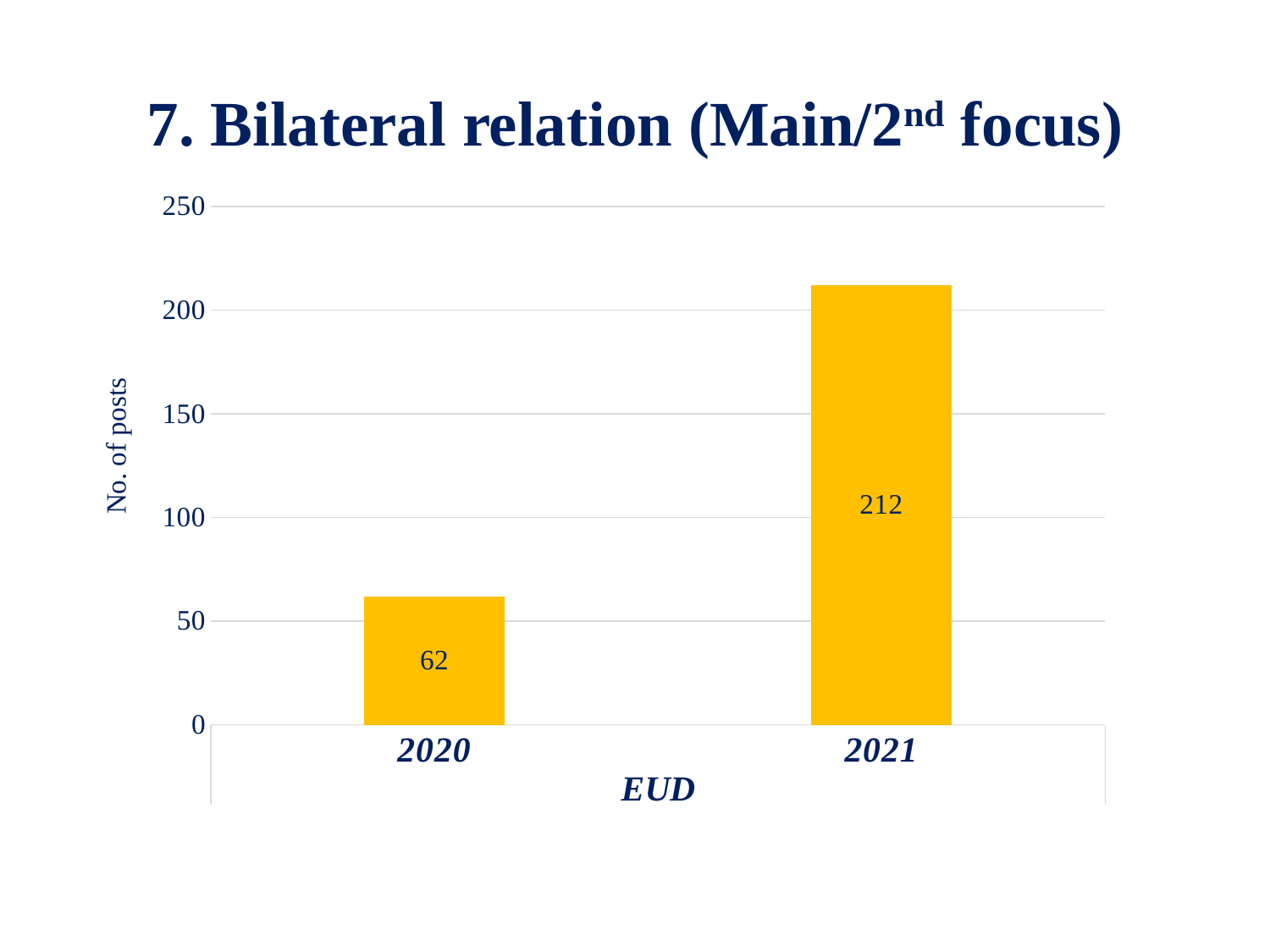
What is the number of posts for 2021? 212 Is the value for 2020 greater or less than 100? less What is the number of posts for 2020? 62 What kind of chart is shown on the slide? bar chart Which year has the lowest number of posts? 2020 What is the difference in number of posts between 2021 and 2020? 150 Do the values rise or fall from 2020 to 2021? rise What is the label of the x axis? EUD Which year has more posts, 2020 or 2021? 2021 Is the value for 2021 greater or less than 200? greater Which year has the highest number of posts? 2021 How many years are shown on the chart? 2